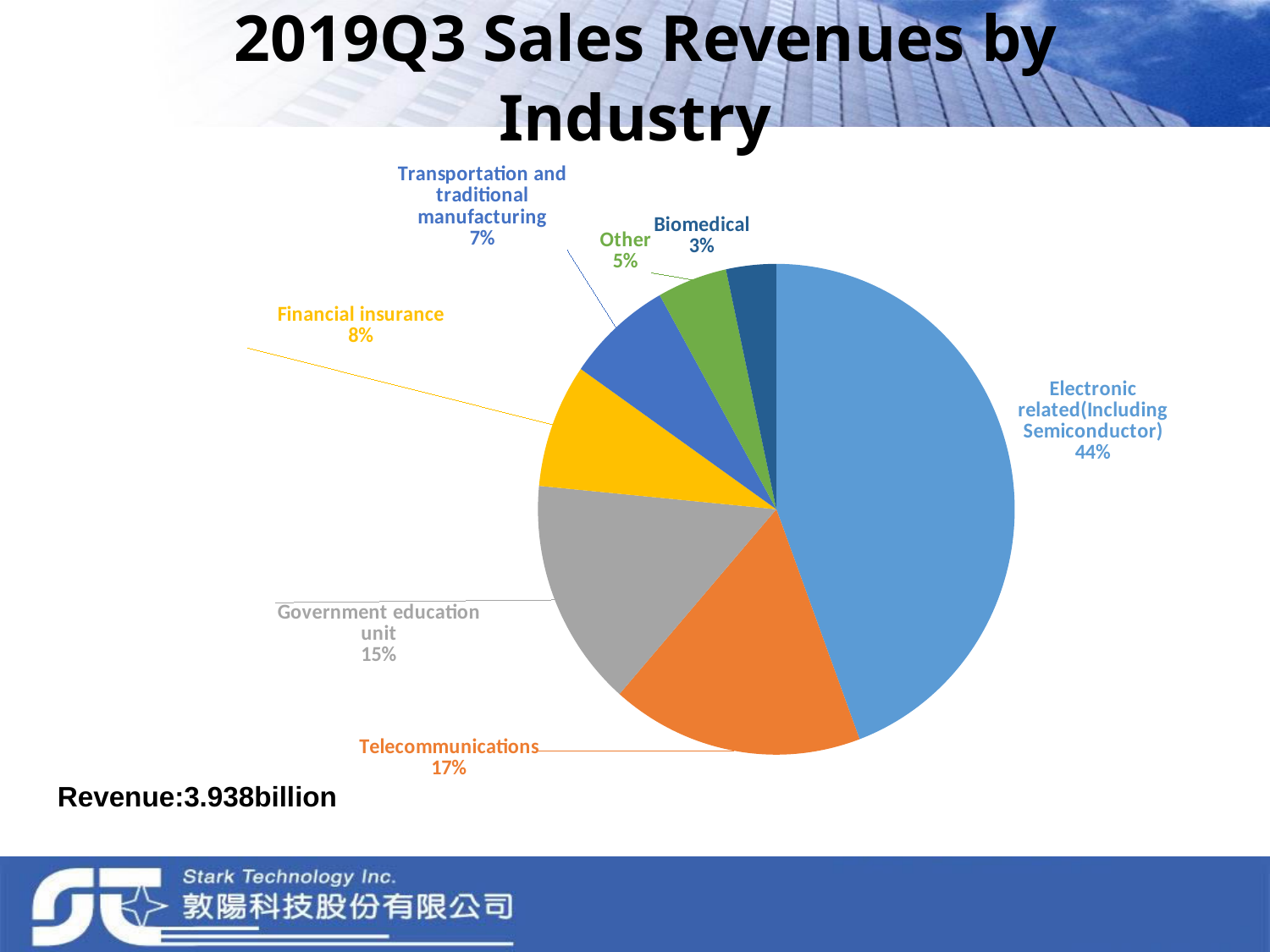
Which industry has the largest share of 2019Q3 sales revenues? Electronic related(Including Semiconductor) How many industry categories are shown in the pie chart? 7 What share of 2019Q3 sales revenues comes from Government education unit? 15% Which industry has the smallest share of 2019Q3 sales revenues? Biomedical Which has a larger share of 2019Q3 sales revenues, Transportation and traditional manufacturing or Other? Transportation and traditional manufacturing What is the difference in percentage points between the Telecommunications share and the Government education unit share? 2 percentage points What share of 2019Q3 sales revenues comes from Biomedical? 3% What total revenue figure is stated on the slide? 3.938billion What share of 2019Q3 sales revenues comes from Electronic related (Including Semiconductor)? 44% What kind of chart is shown on the slide? pie chart